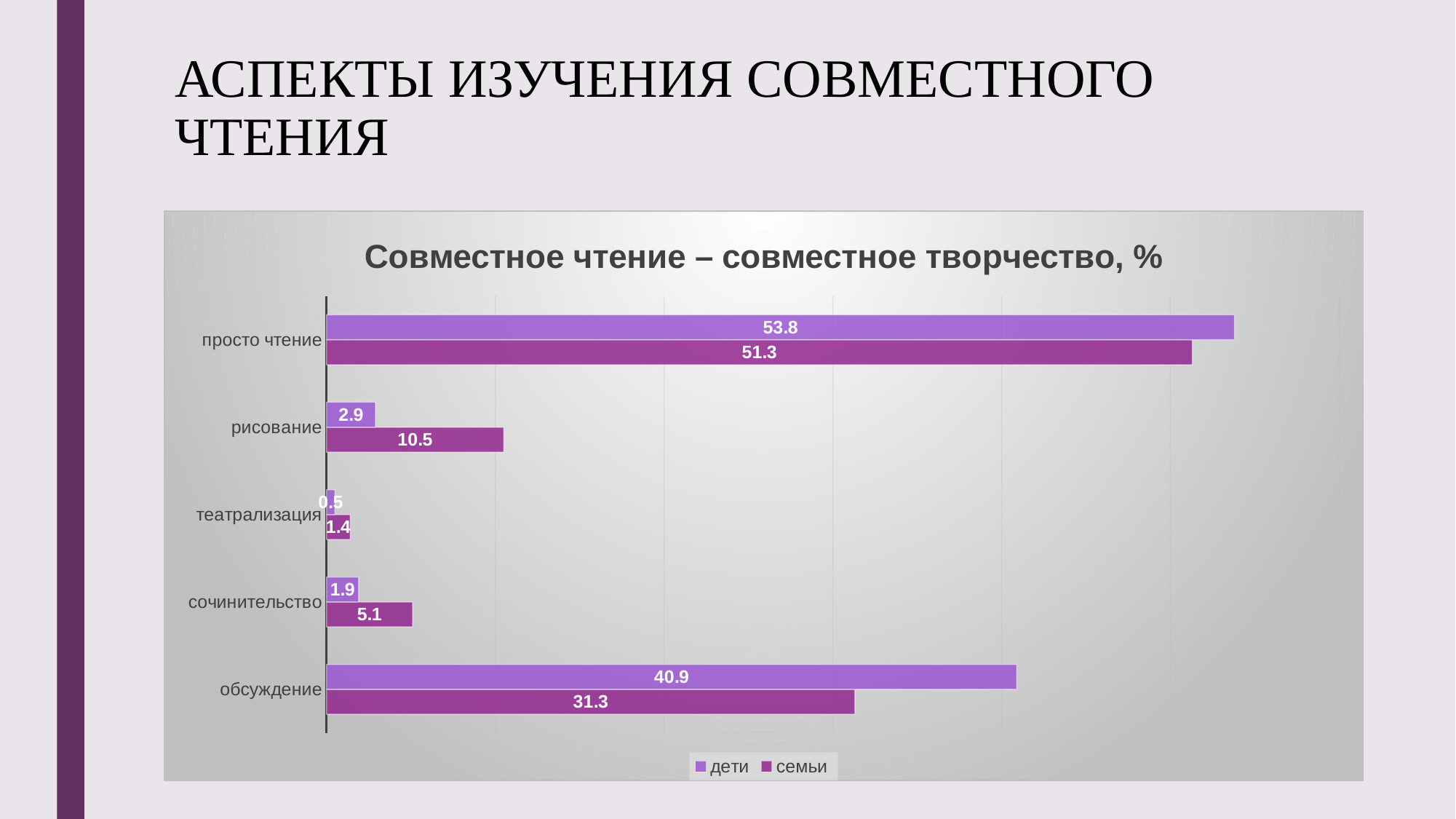
What is the value for дети in the просто чтение category? 53.8 What is the value for семьи in the обсуждение category? 31.3 What is the title of the chart? Совместное чтение – совместное творчество, % Which is larger for рисование: the дети value or the семьи value? семьи What is the difference between the дети and семьи values for обсуждение? 9.6 What is the value for семьи in the рисование category? 10.5 How many categories are shown on the chart? 5 What kind of chart is shown on the slide? bar chart How many series does the legend list? 2 Which category has the highest value for the дети series? просто чтение What is the value for дети in the сочинительство category? 1.9 Which category has the lowest value for the семьи series? театрализация